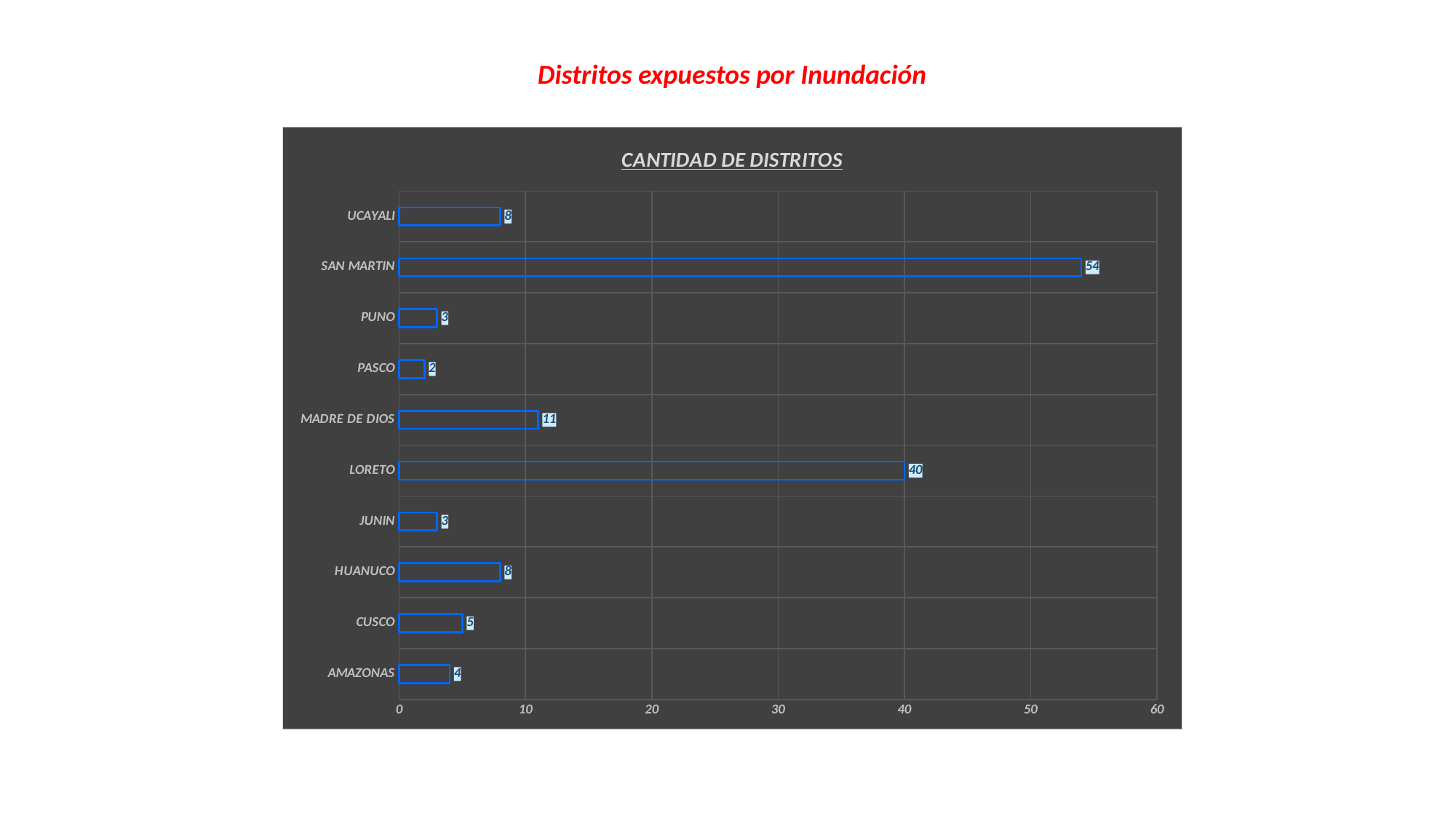
What is the difference between the values for SAN MARTIN and LORETO? 14 Which category has the highest value? SAN MARTIN What is the difference between the values for HUANUCO and JUNIN? 5 What is the title of the chart? CANTIDAD DE DISTRITOS How many categories are shown in the chart? 10 Which is larger, the value for CUSCO or the value for AMAZONAS? CUSCO Which category has the lowest value? PASCO What is the value for MADRE DE DIOS? 11 Is the value for LORETO greater or less than 30? greater What is the value for LORETO? 40 What is the value for SAN MARTIN? 54 What kind of chart is shown on the slide? bar chart